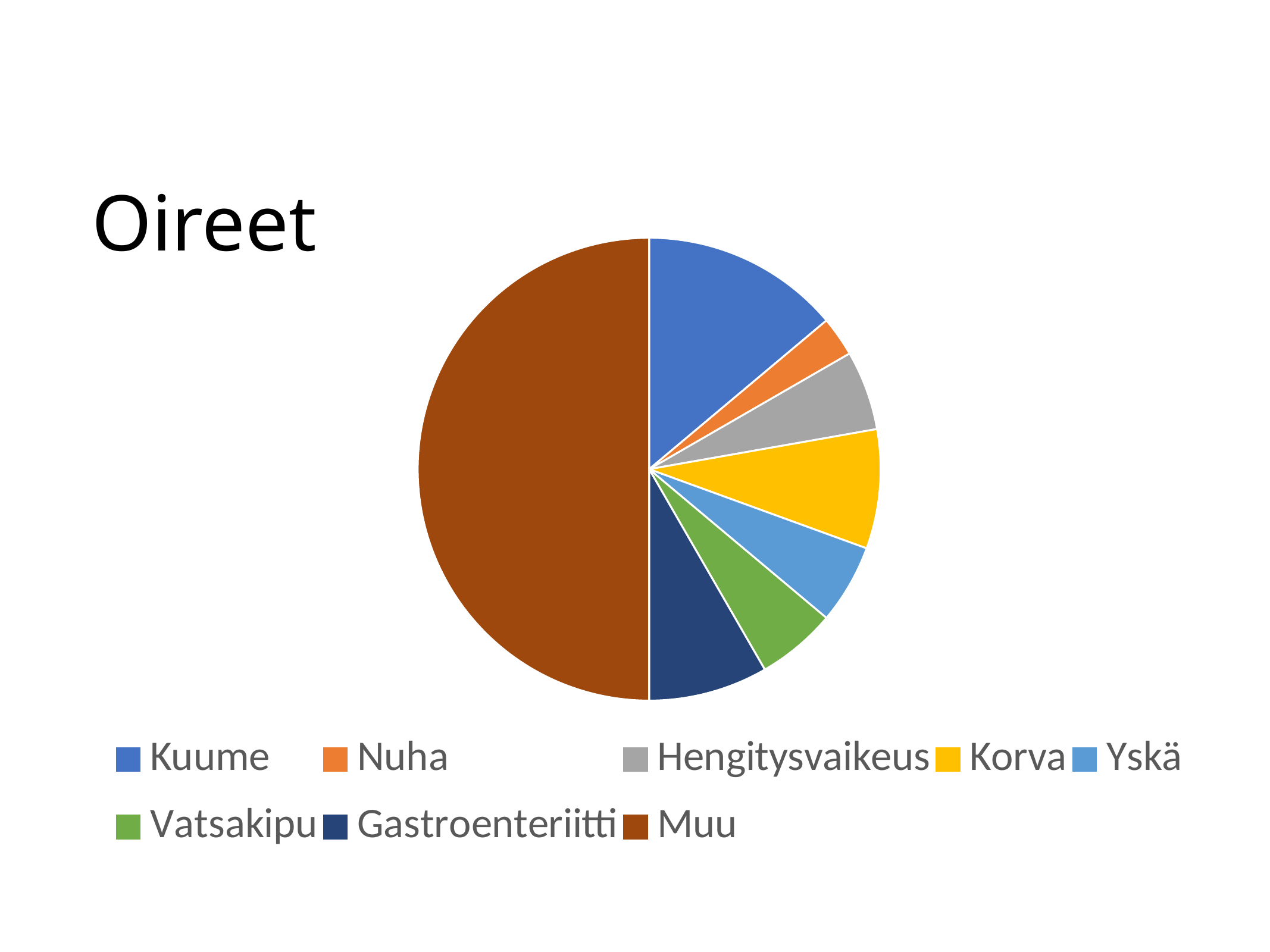
What is the title of the chart? Oireet Which slice is larger, Korva or Nuha? Korva How many categories does the pie chart have? 8 Which slice is larger, Yskä or Nuha? Yskä Which category has the smallest slice of the pie? Nuha Which slice is larger, Muu or Kuume? Muu What colour is the Muu slice in the pie chart? brown Which category has the largest slice of the pie? Muu What kind of chart is shown on the slide? pie chart